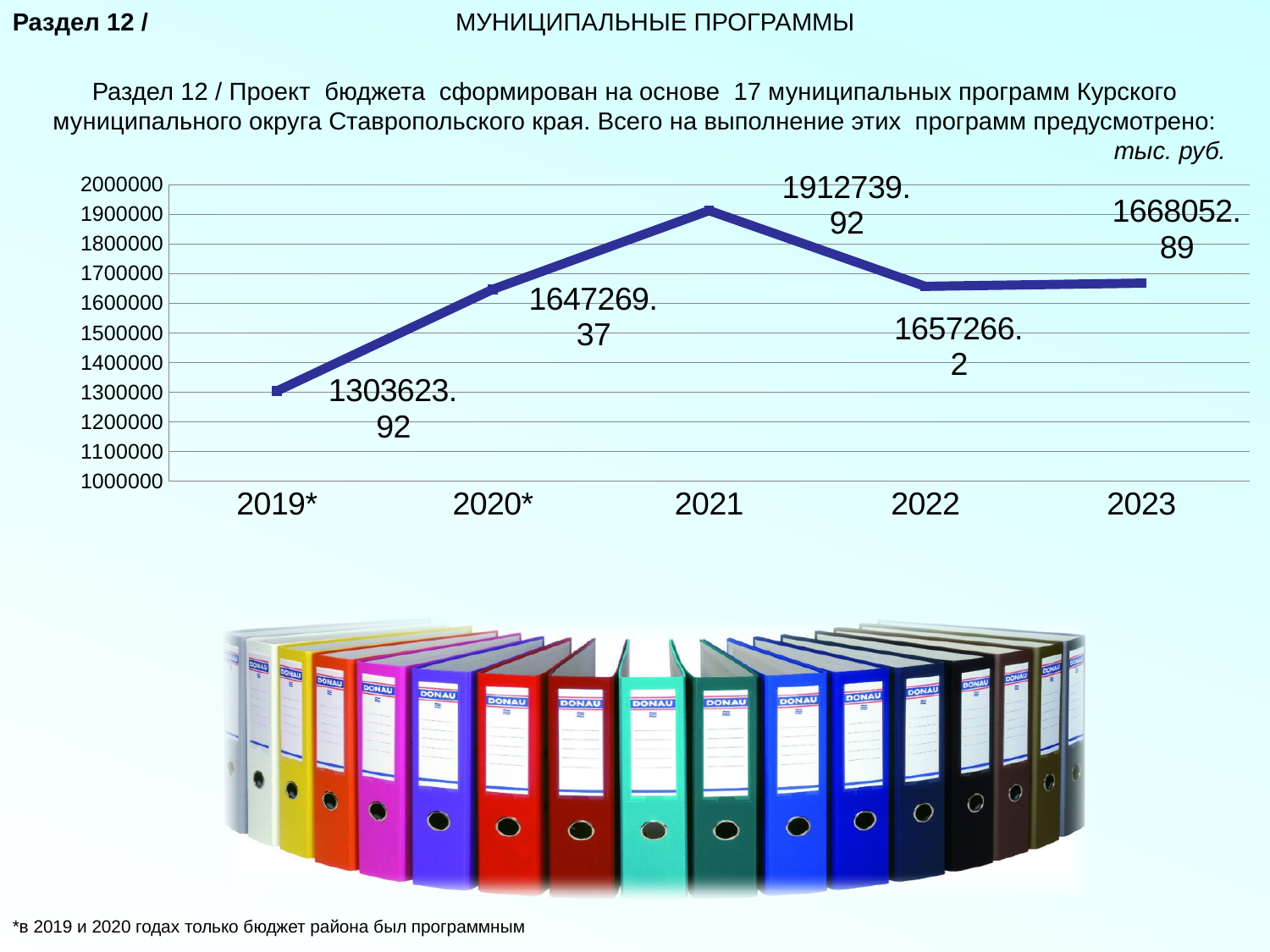
Which year has the lowest value on the chart? 2019* What is the value for 2021 on the chart? 1912739.92 Which year has the highest value on the chart? 2021 What is the value for 2022 on the chart? 1657266.2 Which is larger, the value for 2020* or the value for 2021? 2021 What is the difference between the values for 2021 and 2019*? 609116 What is the value for 2019* on the chart? 1303623.92 What is the difference between the values for 2020* and 2019*? 343645.45 Is the value for 2019* greater or less than 1400000? less What is the value for 2023 on the chart? 1668052.89 How many years are plotted on the chart? 5 What kind of chart is shown on the slide? line chart